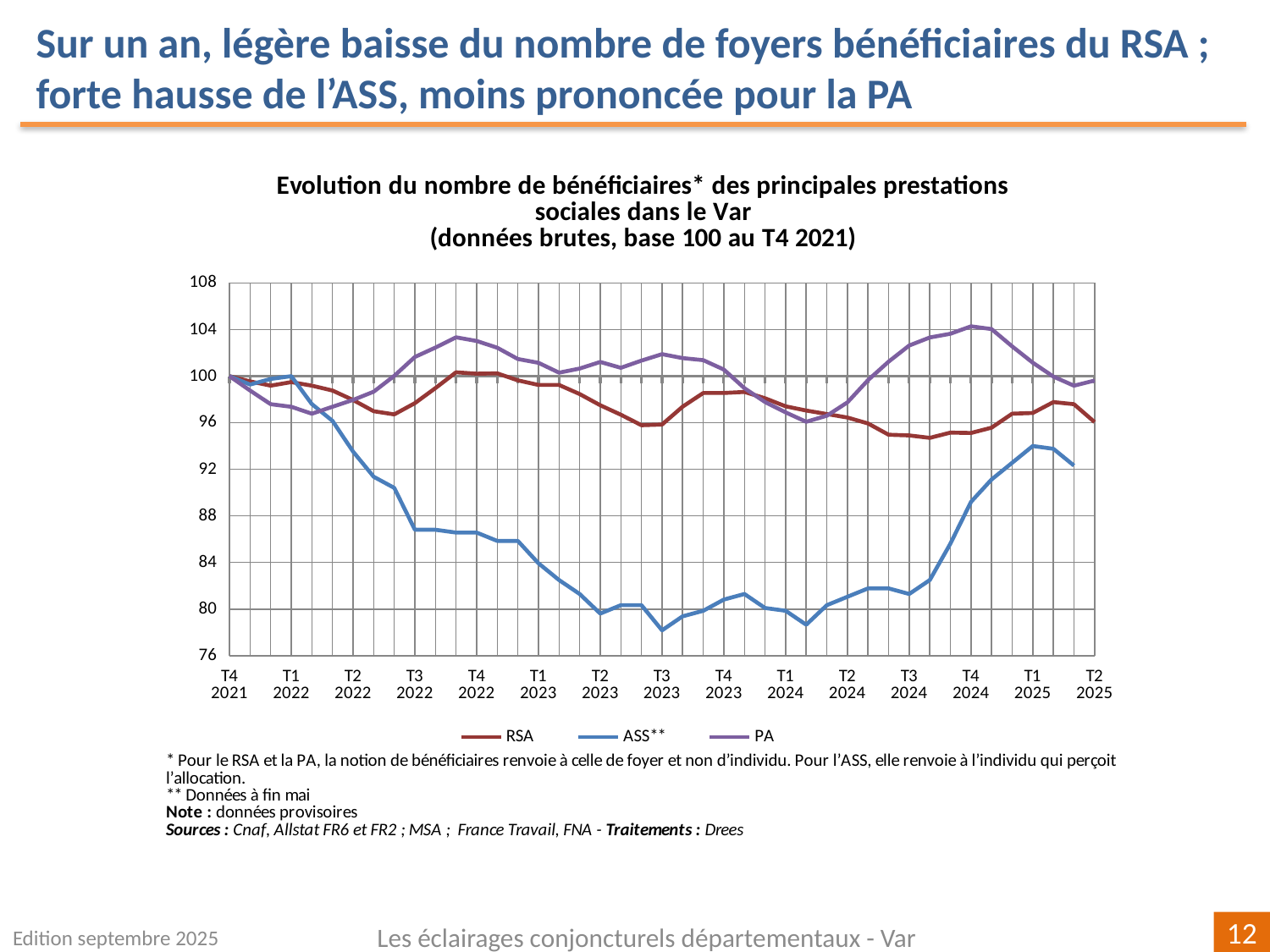
What is the value of the RSA series at T4 2021? 100 How many quarter labels are shown on the x axis? 15 Which series has the lowest value at T3 2023? ASS** How many series does the legend list? 3 Is the value of the PA series at T4 2024 greater or less than 100? greater Is the value of the ASS** series at T3 2023 greater or less than 80? less What base period is used for the index of 100 according to the chart title? T4 2021 Does the ASS** series rise or fall between T4 2021 and T3 2023? Fall Is the value of the ASS** series at T3 2022 greater or less than 88? less What kind of chart is shown on the slide? Line chart